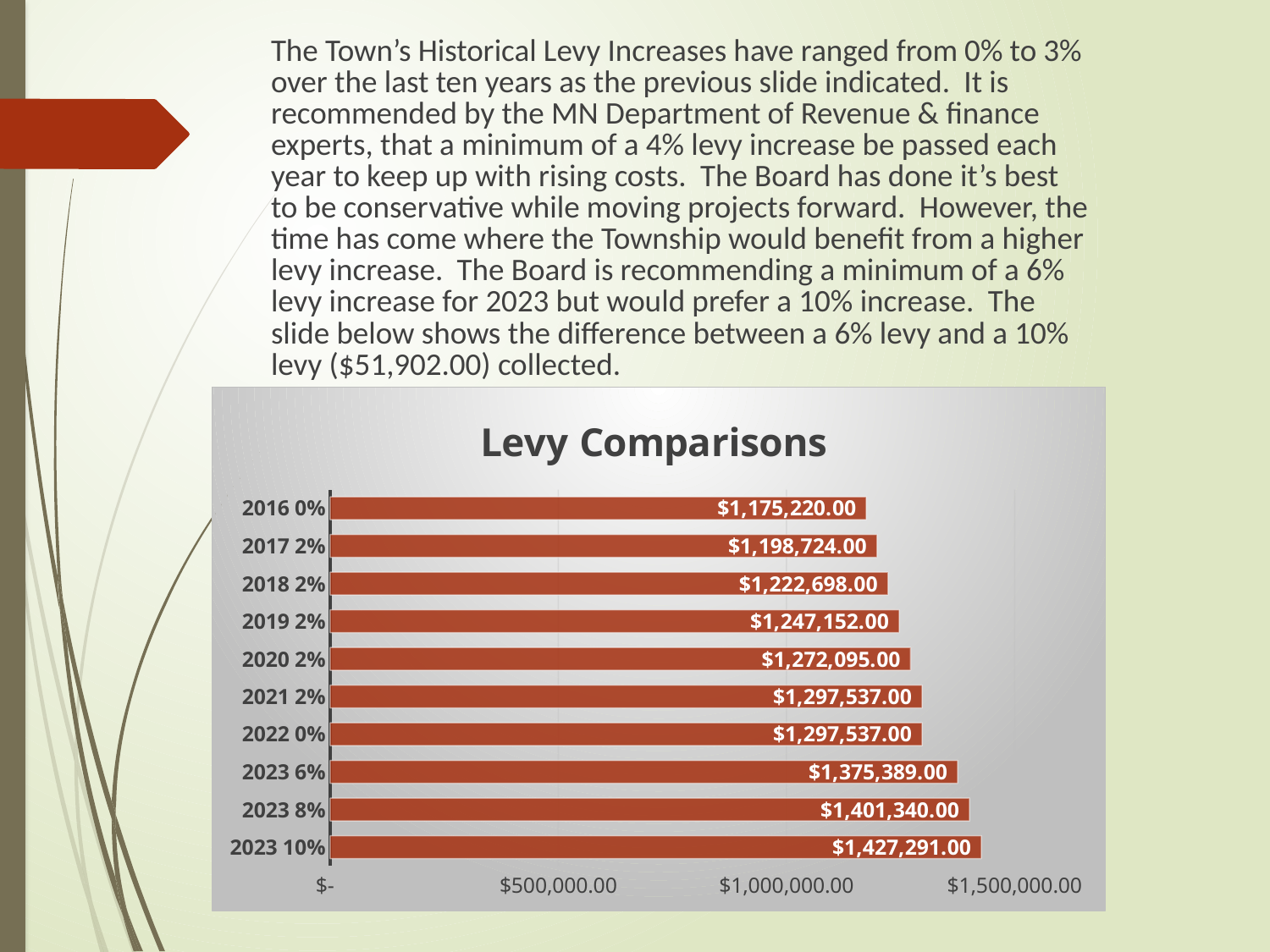
Is the levy value for 2019 2% greater or less than $1,000,000.00? greater What is the difference between the levy values for 2023 10% and 2023 6%? $51,902.00 What is the levy value shown for 2016 0%? $1,175,220.00 Which category has the lowest levy value? 2016 0% What kind of chart is shown on the slide? Bar chart Which is larger, the levy value for 2023 8% or for 2020 2%? 2023 8% How many categories (bars) are shown in the chart? 10 What is the levy value shown for 2023 6%? $1,375,389.00 What is the levy value shown for 2023 10%? $1,427,291.00 What is the difference between the levy values for 2017 2% and 2016 0%? $23,504.00 What is the levy value shown for 2020 2%? $1,272,095.00 Which category has the highest levy value? 2023 10%